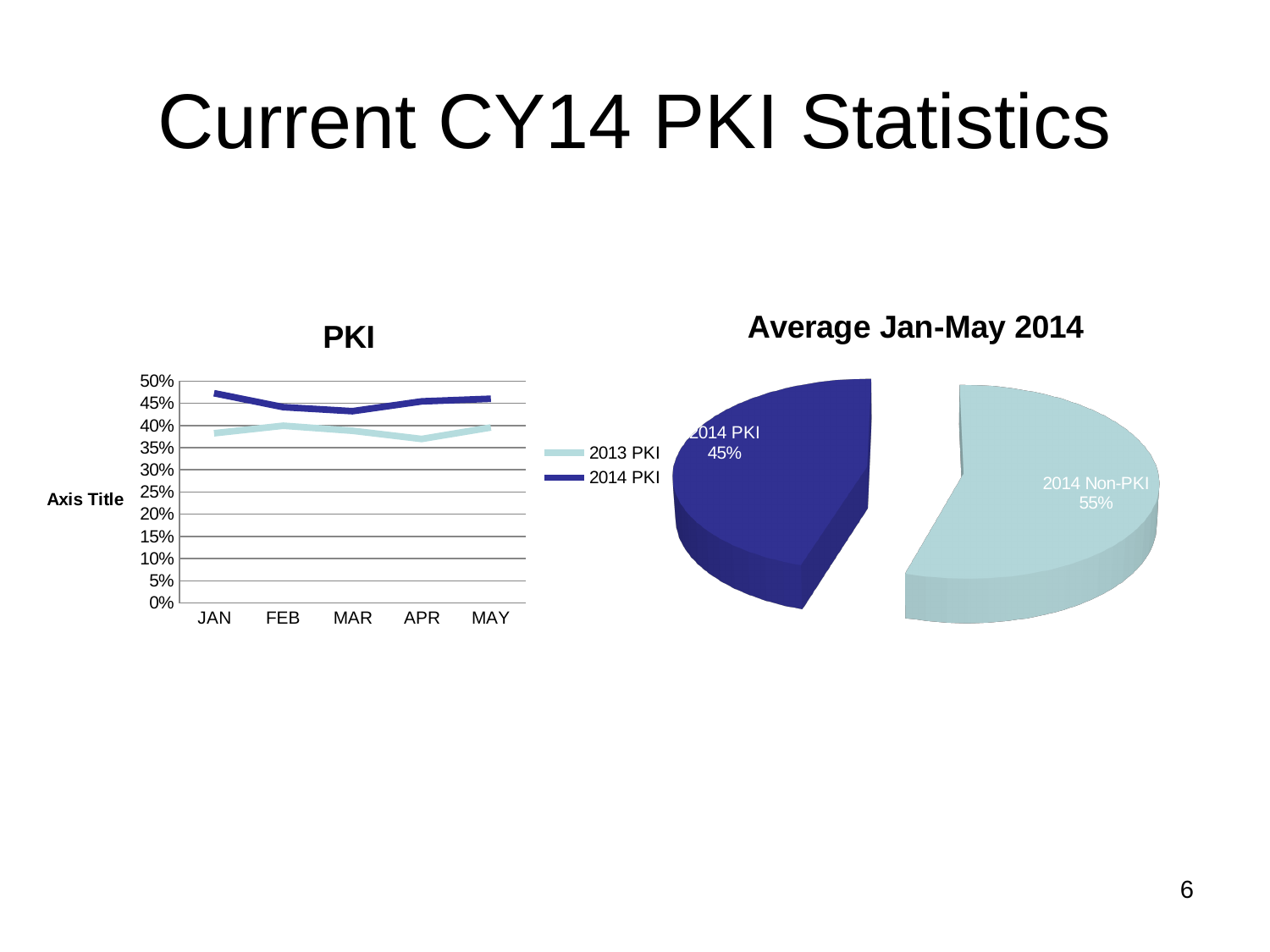
In the "PKI" line chart, how many months are shown on the x axis? 5 In the "Average Jan-May 2014" pie chart, which slice is the largest? 2014 Non-PKI In the "PKI" line chart, is the value for 2014 PKI in FEB greater or less than 35%? greater In the "PKI" line chart, which series is higher in MAY, 2013 PKI or 2014 PKI? 2014 PKI In the "PKI" line chart, is the value for 2013 PKI in APR greater or less than 40%? less In the "Average Jan-May 2014" pie chart, what share is labelled for 2014 Non-PKI? 55% In the "Average Jan-May 2014" pie chart, what share is labelled for 2014 PKI? 45% In the "PKI" line chart, is the value for 2014 PKI in MAR greater or less than 40%? greater What kind of chart is the chart titled "Average Jan-May 2014" on the right of the slide? pie chart What kind of chart is the chart titled "PKI" on the left of the slide? line chart In the "Average Jan-May 2014" pie chart, what is the difference between the 2014 Non-PKI share and the 2014 PKI share? 10% In the "PKI" line chart, how many series does the legend list? 2